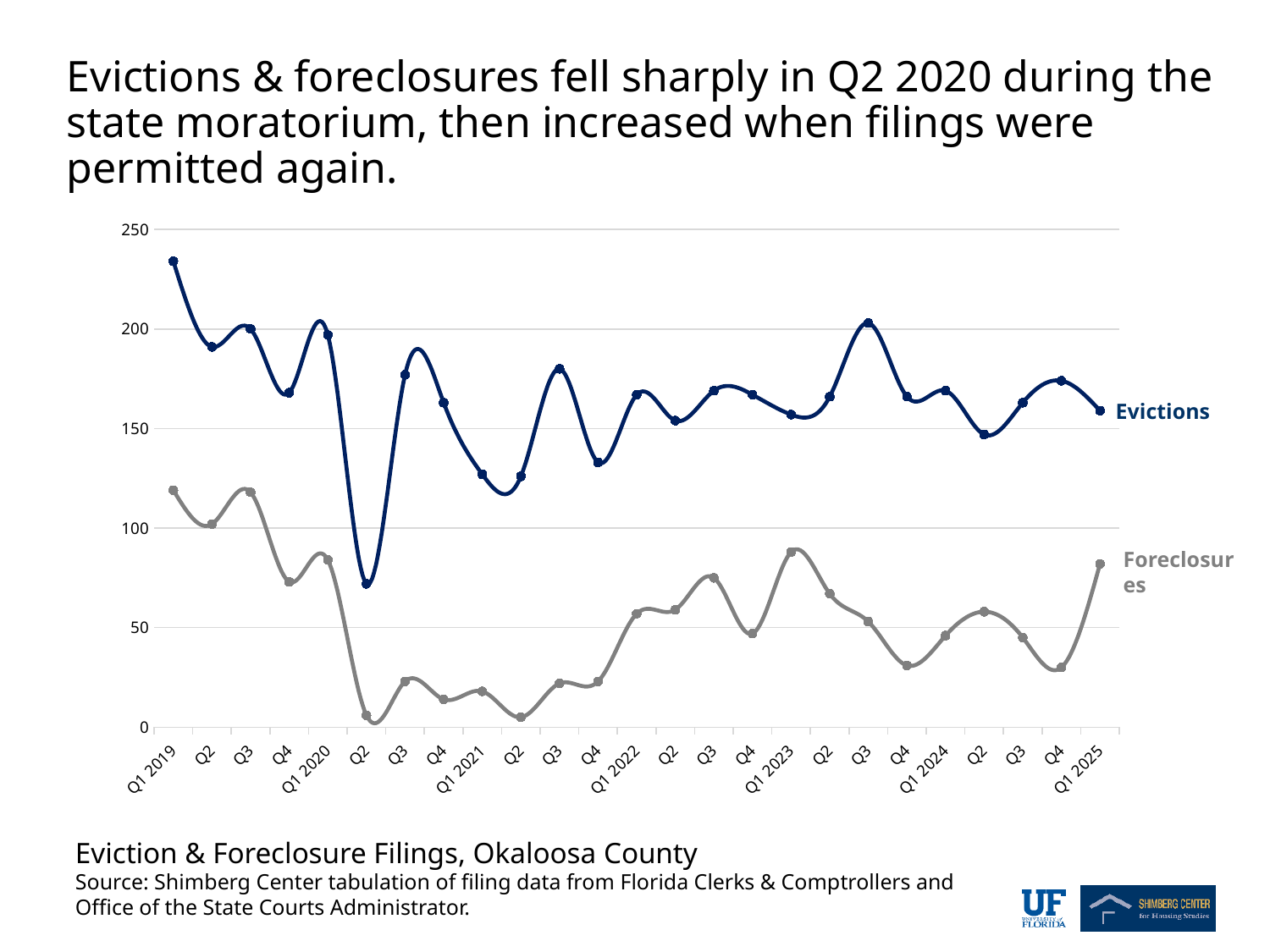
In which quarter do Evictions reach their highest value? Q1 2019 Which series has the higher value in Q1 2025, Evictions or Foreclosures? Evictions How many series are plotted on the chart? 2 Is the Foreclosures value for Q2 2020 greater or less than 50? less Do Evictions rise or fall between Q1 2019 and Q2 2020? Fall In which quarter do Evictions reach their lowest value? Q2 2020 What kind of chart is shown on the slide? Line chart Is the Foreclosures value for Q1 2025 greater or less than 50? greater Is the Evictions value for Q2 2020 greater or less than 100? less What is the title of the chart given below it? Eviction & Foreclosure Filings, Okaloosa County How many quarterly data points does each line have, from Q1 2019 to Q1 2025? 25